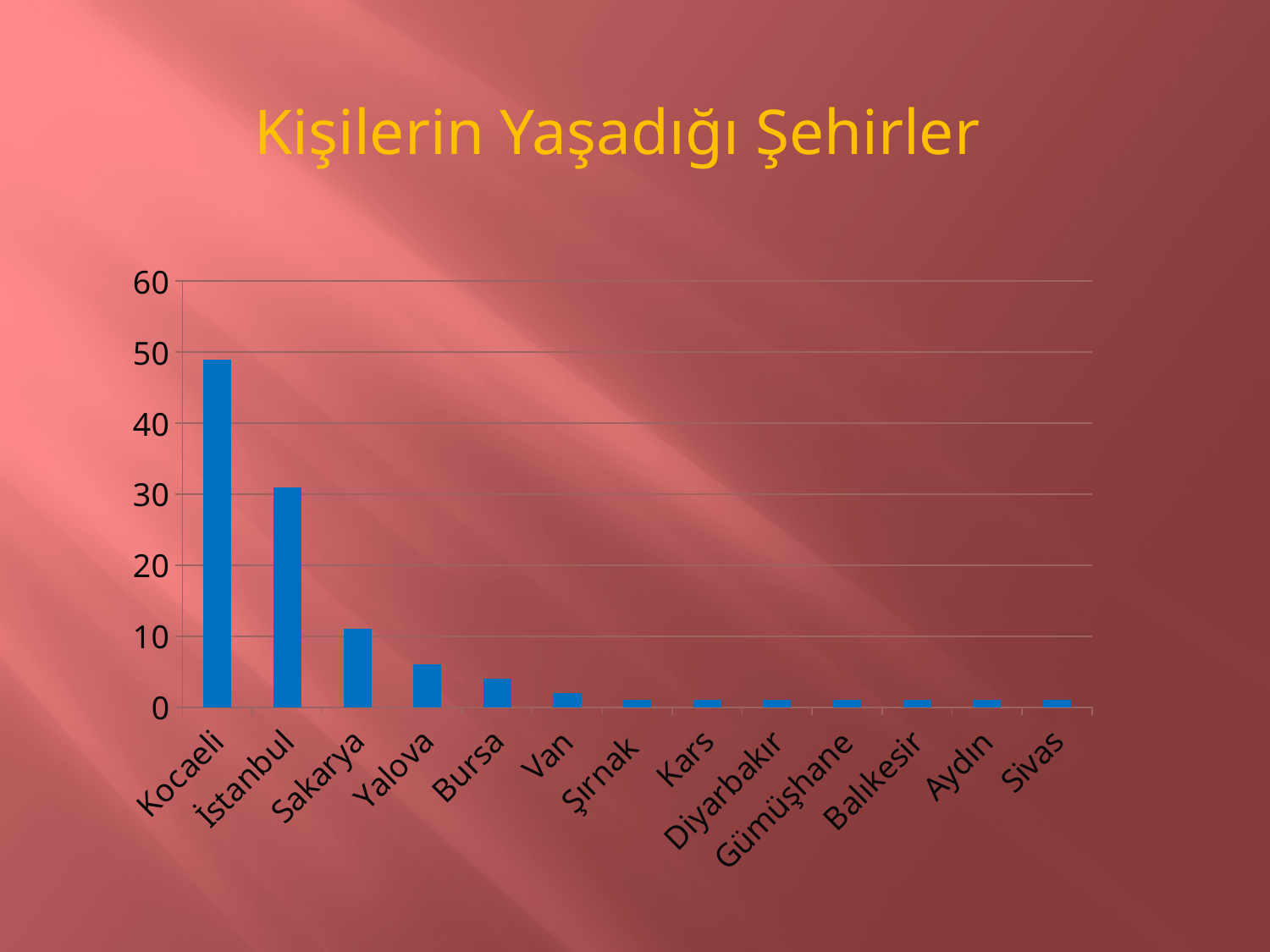
Which is larger, the value for Bursa or the value for Yalova? Yalova Which is larger, the value for İstanbul or the value for Sakarya? İstanbul What is the title of the chart? Kişilerin Yaşadığı Şehirler Is the value for Kocaeli greater or less than 40? greater Which city has the highest value in the chart? Kocaeli Is the value for Yalova greater or less than 10? less Do the values rise or fall moving from left to right along the x axis? fall Is the value for İstanbul greater or less than 40? less How many cities are shown on the x axis of the chart? 13 What kind of chart is shown on the slide? bar chart